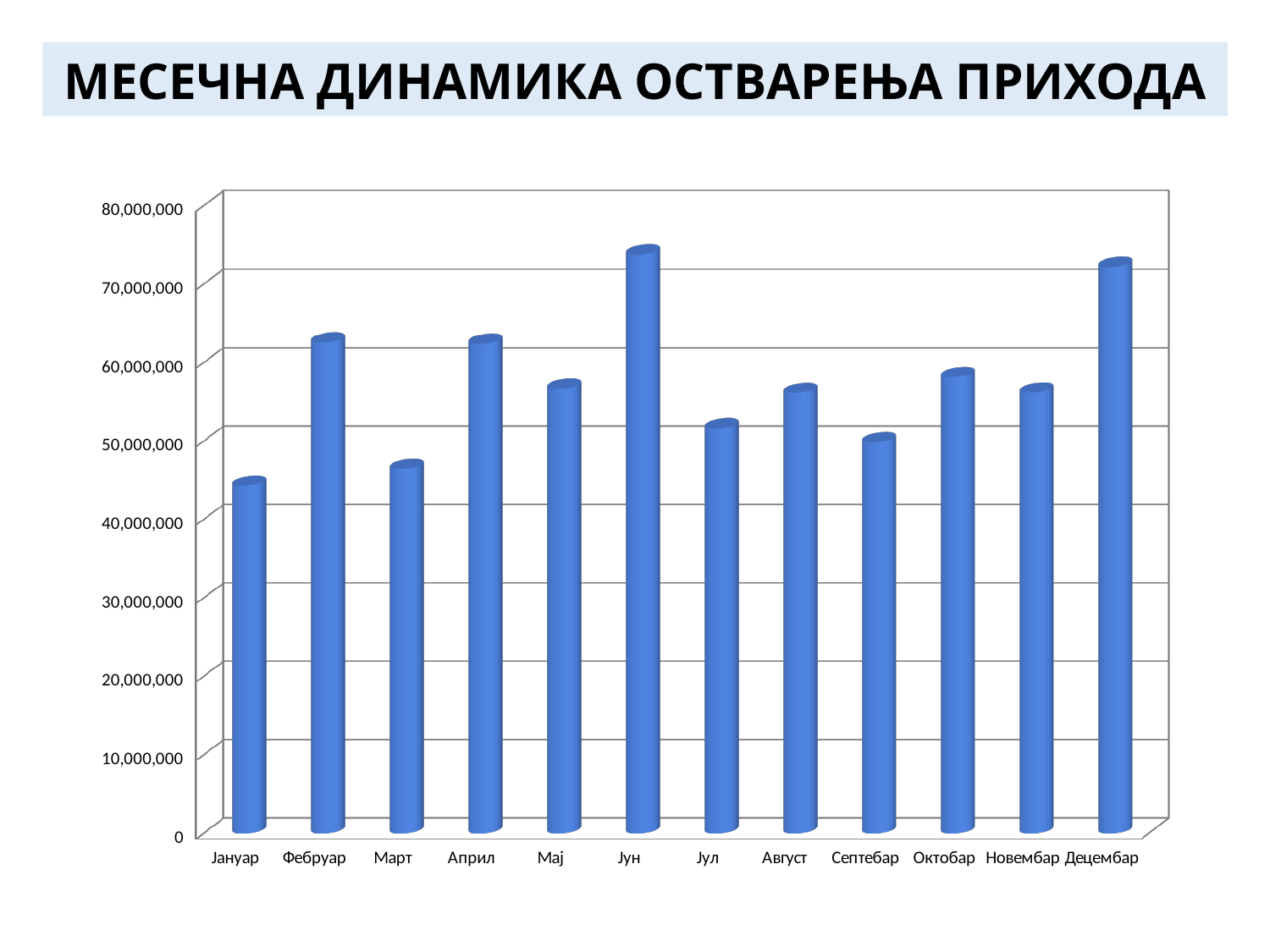
Is the value for Мај greater or less than 60,000,000? less Which has the larger value, Јун or Јануар? Јун Is the value for Март greater or less than 50,000,000? less What kind of chart is shown on the slide? Bar chart Is the value for Јун greater or less than 70,000,000? greater Which has the larger value, Фебруар or Март? Фебруар What is the highest value shown on the vertical axis? 80,000,000 What is the title of the slide? МЕСЕЧНА ДИНАМИКА ОСТВАРЕЊА ПРИХОДА How many months (categories) are plotted on the chart? 12